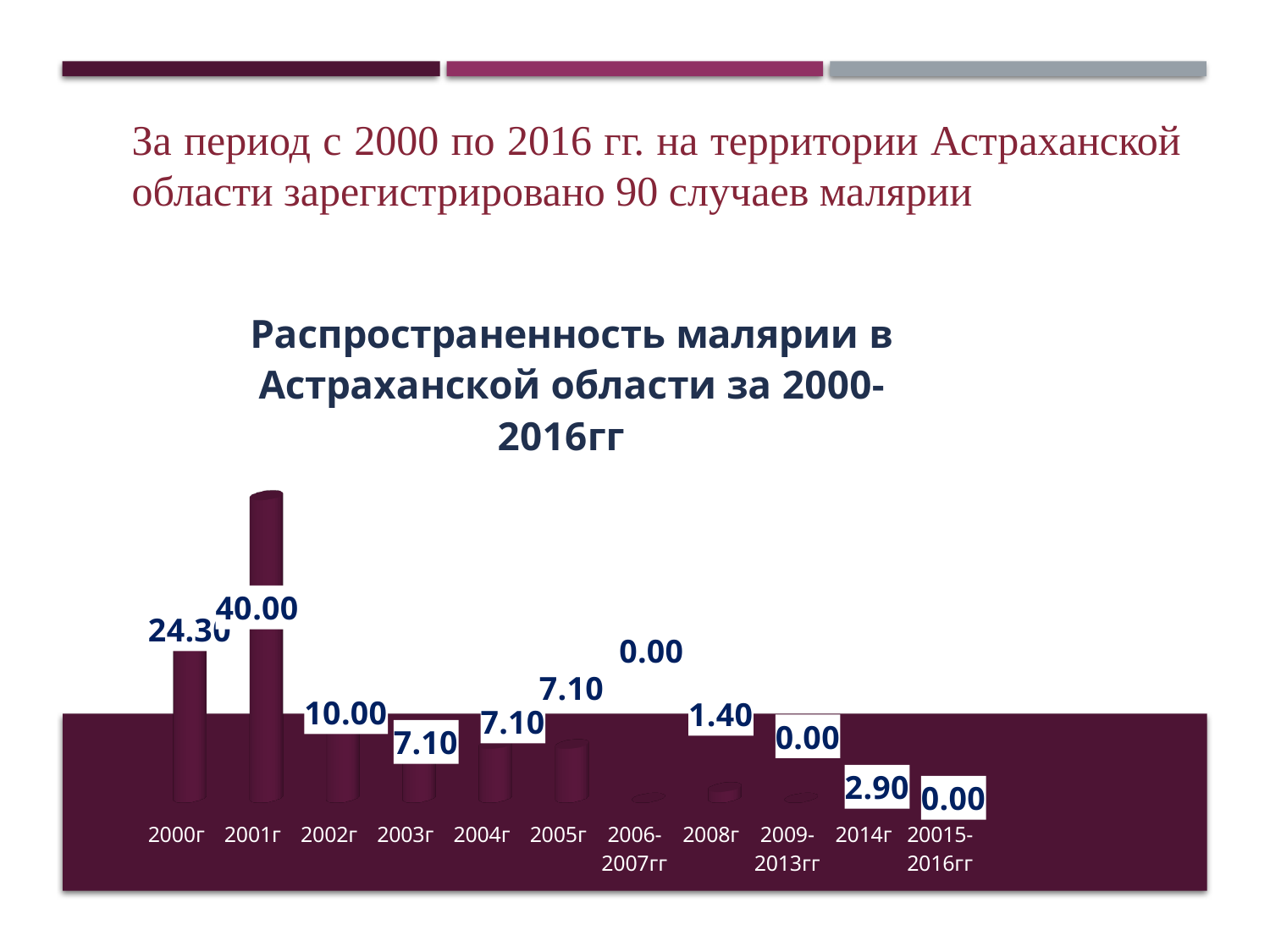
What is the value for 2002г? 10.00 How many categories are shown on the x axis? 11 What is the value for 2014г? 2.90 What is the value for 2001г? 40.00 What is the value for 2009-2013гг? 0.00 Do the values rise or fall from 2001г to 2005г? Fall What is the value for 2008г? 1.40 What is the difference between the values for 2001г and 2002г? 30.00 What kind of chart is this? Bar chart What is the value for 2003г? 7.10 Which is larger, the value for 2000г or the value for 2001г? 2001г Which category has the highest value? 2001г